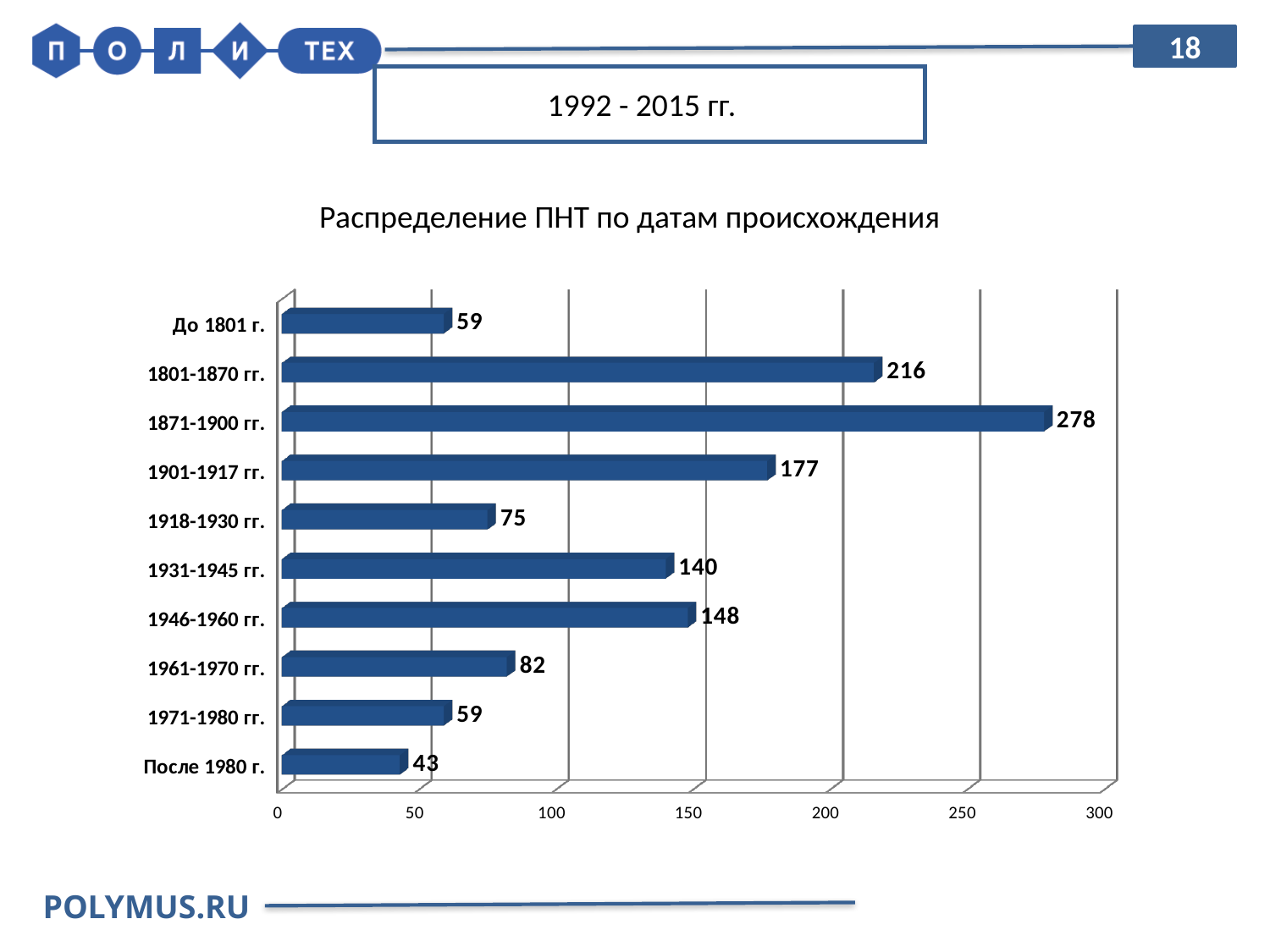
What is the difference between the values for 1871-1900 гг. and 1801-1870 гг.? 62 Is the value for 1961-1970 гг. greater or less than 100? less What is the difference between the values for 1946-1960 гг. and 1931-1945 гг.? 8 How many categories are shown in the chart? 10 Which is larger, the value for 1901-1917 гг. or the value for 1946-1960 гг.? 1901-1917 гг. What is the value for После 1980 г.? 43 What kind of chart is shown on the slide? bar chart What is the value for 1871-1900 гг.? 278 Which category has the lowest value? После 1980 г. Which category has the highest value? 1871-1900 гг. What is the value for 1931-1945 гг.? 140 What is the title of the chart? Распределение ПНТ по датам происхождения